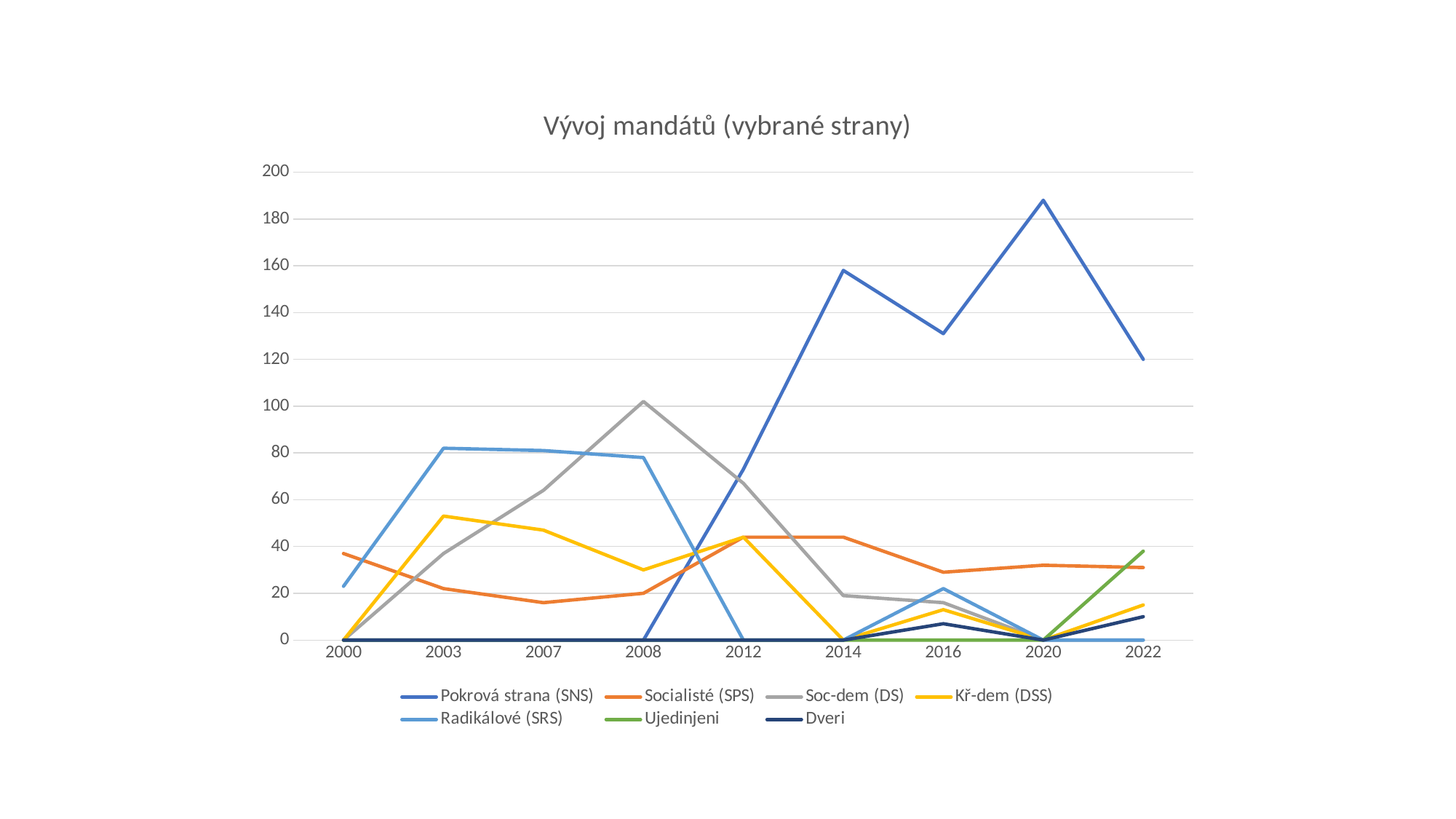
Is the value for Soc-dem (DS) in 2008 greater or less than 80? greater In which year does Pokrová strana (SNS) reach its highest value? 2020 Is the value for Pokrová strana (SNS) in 2020 greater or less than 180? greater How many series does the legend list? 7 Which series has the highest value in 2003? Radikálové (SRS) What type of chart is shown on the slide? line chart How many years are shown on the x axis? 9 In 2012, which is larger: Socialisté (SPS) or Soc-dem (DS)? Soc-dem (DS) Is the value for Radikálové (SRS) in 2003 greater or less than 60? greater What is the title of the chart? Vývoj mandátů (vybrané strany) What is the value for Radikálové (SRS) in 2012? 0 What is the value for Pokrová strana (SNS) in 2008? 0